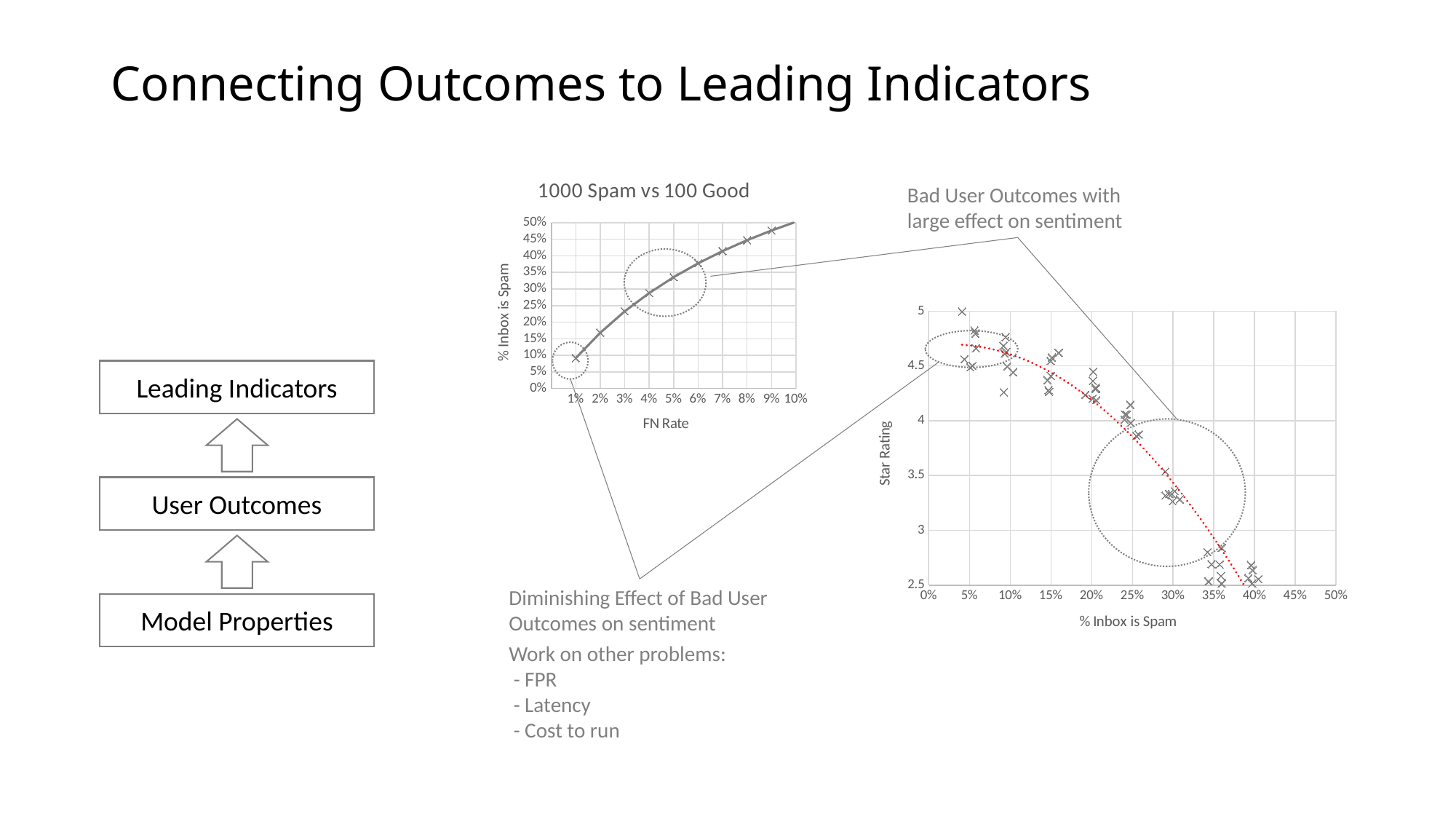
In the '1000 Spam vs 100 Good' chart, is the value at 5% FN Rate greater or less than 30%? greater What is the title of the chart on the upper middle of the slide? 1000 Spam vs 100 Good In the '1000 Spam vs 100 Good' chart, is the value at 1% FN Rate greater or less than 15%? less In the '1000 Spam vs 100 Good' chart, which FN Rate has the lowest % Inbox is Spam? 1% What kind of chart is the chart on the right of the slide with Star Rating on the y axis? scatter chart In the '1000 Spam vs 100 Good' chart, which FN Rate has the highest % Inbox is Spam? 10% In the Star Rating chart on the right, what is the label of the x axis? % Inbox is Spam In the Star Rating chart on the right, does Star Rating rise or fall as % Inbox is Spam increases? fall In the '1000 Spam vs 100 Good' chart, how many data points are plotted? 10 In the '1000 Spam vs 100 Good' chart, does the % Inbox is Spam rise or fall as FN Rate increases? rise In the '1000 Spam vs 100 Good' chart, is the value at 9% FN Rate greater or less than 40%? greater In the '1000 Spam vs 100 Good' chart, what is the label of the x axis? FN Rate